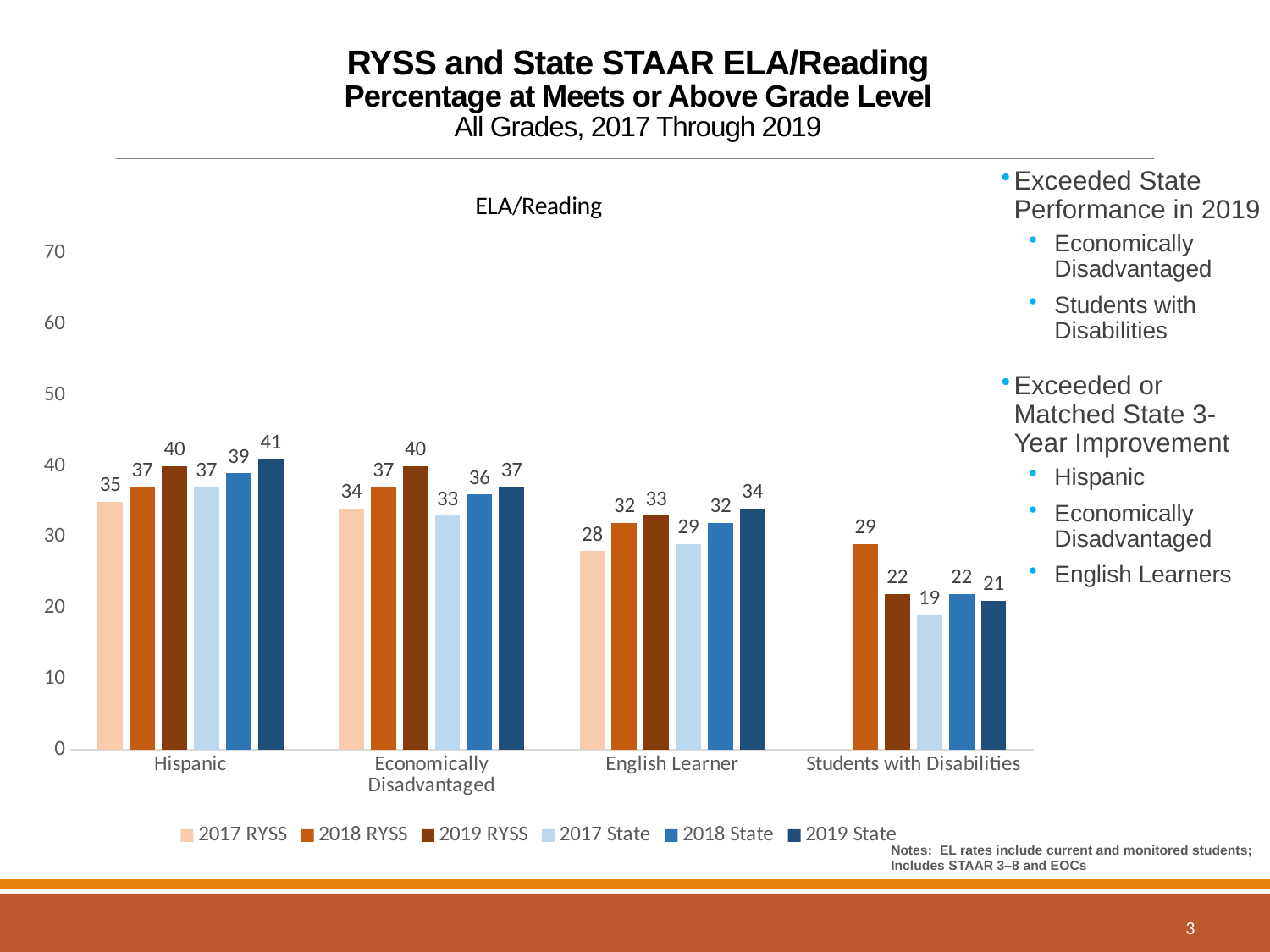
Which category has the lowest 2017 State value? Students with Disabilities What is the 2018 RYSS value for English Learner? 32 Which category has the highest 2019 State value? Hispanic What is the 2017 State value for Students with Disabilities? 19 Do the RYSS values for Hispanic rise or fall from 2017 to 2019? Rise What is the difference between the 2019 RYSS and 2019 State values for Economically Disadvantaged? 3 What is the difference between the 2018 RYSS and 2019 RYSS values for Students with Disabilities? 7 What kind of chart is shown on the slide? Bar chart How many student group categories are shown on the x axis? 4 What is the 2019 RYSS value for Hispanic? 40 How many series does the legend list? 6 For Hispanic, which is larger: the 2019 RYSS value or the 2019 State value? 2019 State